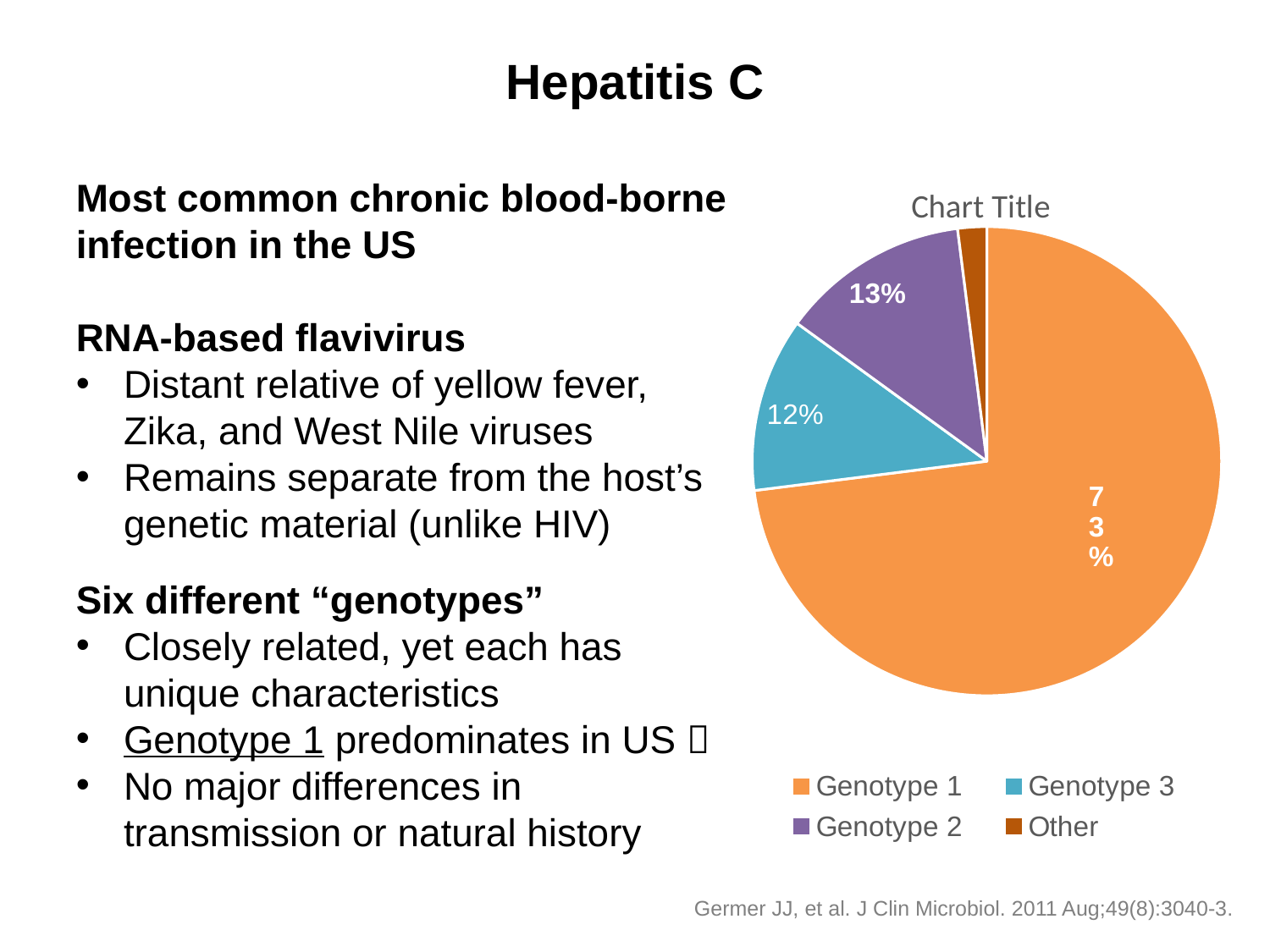
What is the difference in percentage points between Genotype 2 and Genotype 3? 1 percentage point What percentage of the pie does Genotype 1 account for? 73% Which is larger, the slice for Genotype 1 or the slice for Genotype 3? Genotype 1 What kind of chart is shown on the slide? Pie chart What is the title shown above the pie chart? Chart Title What percentage of the pie does Genotype 3 account for? 12% How many entries does the chart legend list? 4 What percentage of the pie does Genotype 2 account for? 13% Which genotype has the largest slice of the pie? Genotype 1 How many slices does the pie chart have? 4 Which category has the smallest slice of the pie? Other What colour is the Genotype 1 slice in the pie chart? Orange